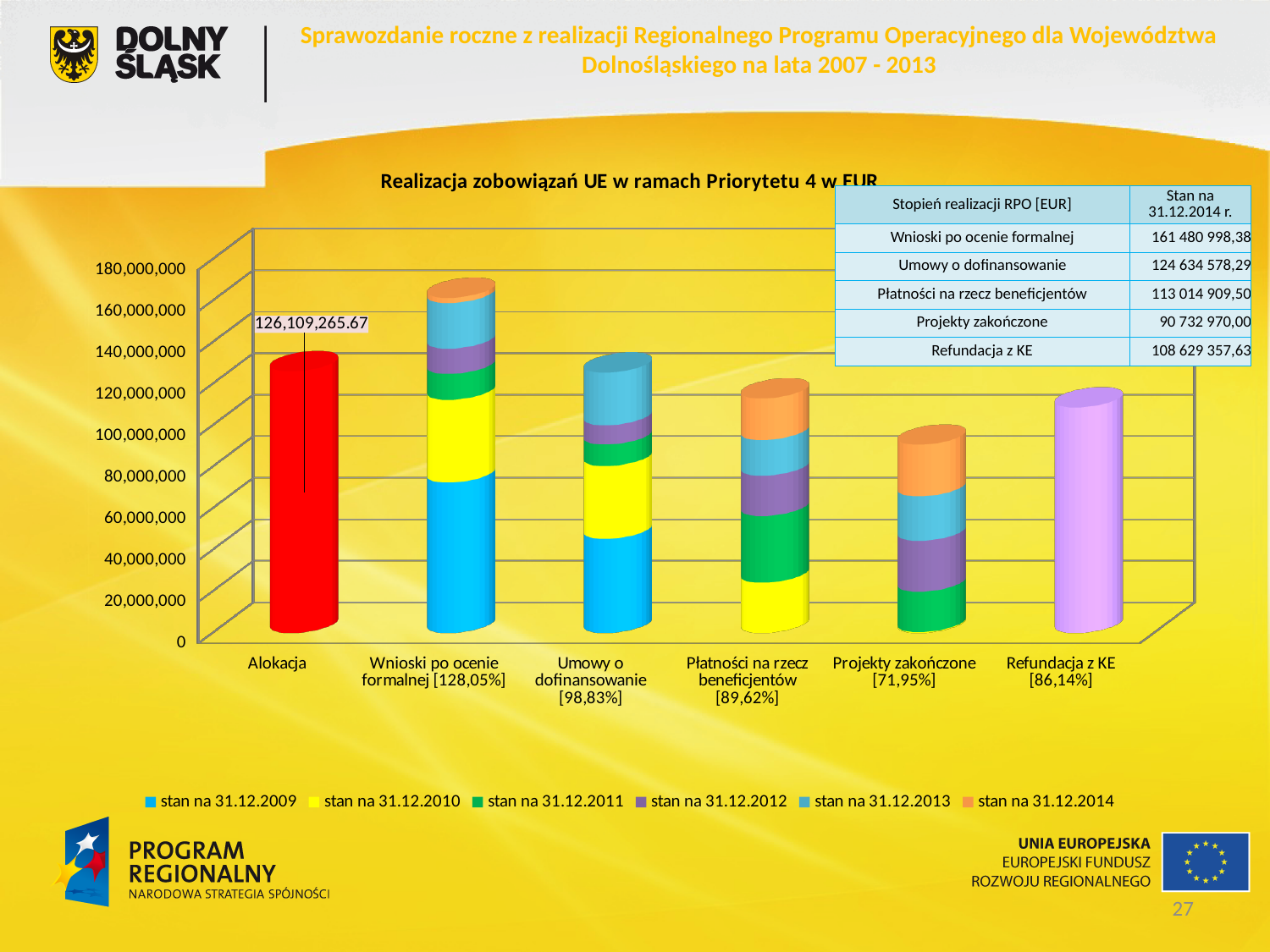
Using the table values as of 31.12.2014, what is the difference between Wnioski po ocenie formalnej and Umowy o dofinansowanie? 36 846 420,09 Which category has the shortest bar in the chart? Projekty zakończone How many categories are shown along the x axis of the chart? 6 What percentage is shown in the x-axis label for Umowy o dofinansowanie? 98,83% According to the table on the chart, what is the value for Projekty zakończone as of 31.12.2014? 90 732 970,00 Which bar is taller: Umowy o dofinansowanie or Płatności na rzecz beneficjentów? Umowy o dofinansowanie According to the table on the chart, what is the value for Wnioski po ocenie formalnej as of 31.12.2014? 161 480 998,38 What kind of chart is shown on the slide? bar chart Which category has the tallest bar in the chart? Wnioski po ocenie formalnej How many series does the chart legend list? 6 What value is labelled on the Alokacja bar? 126,109,265.67 Is the value for Refundacja z KE greater or less than 120,000,000? less